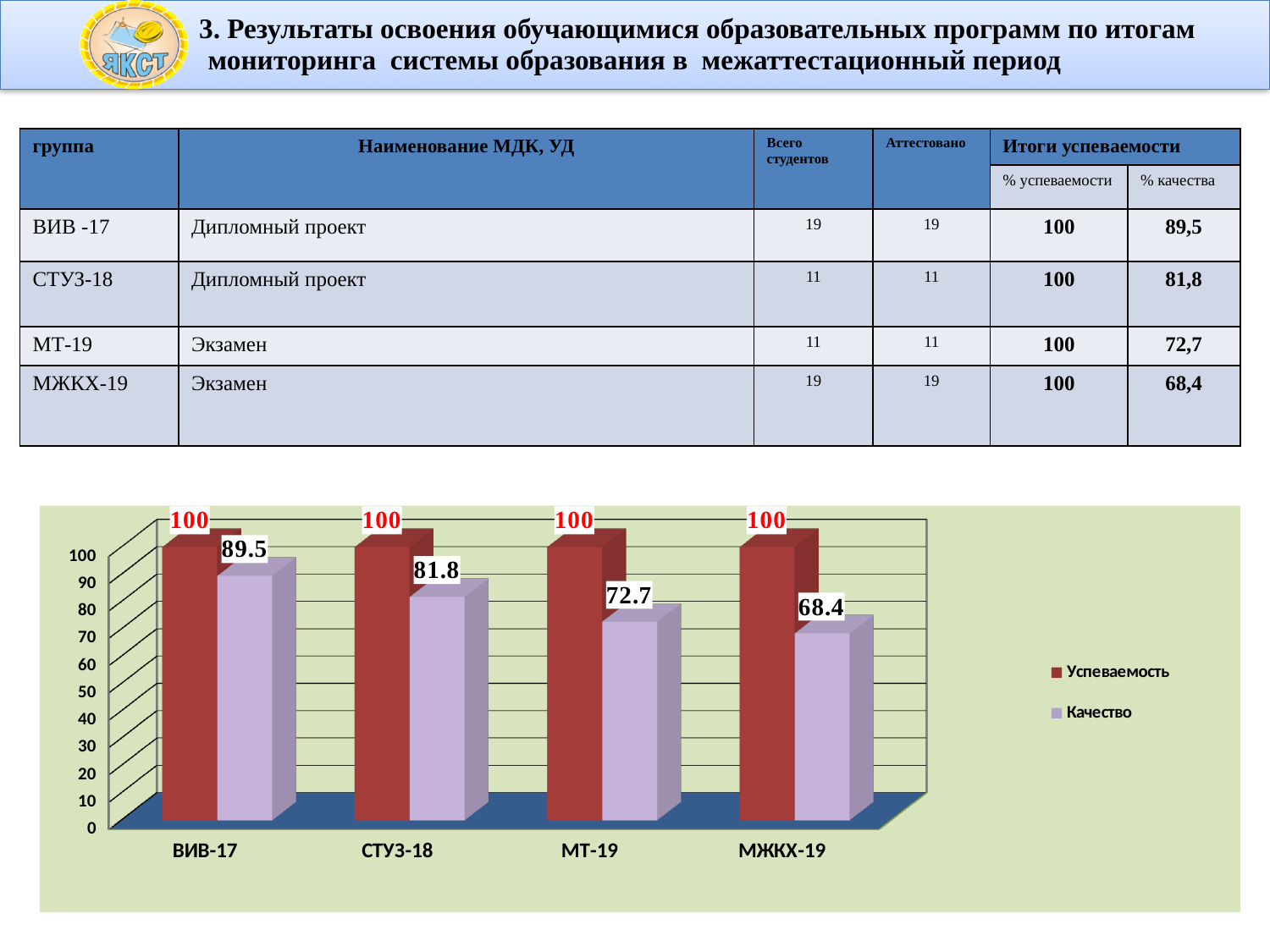
How many series does the chart legend list? 2 What is the difference between the Качество values for ВИВ-17 and МЖКХ-19? 21.1 What is the value of Качество for ВИВ-17? 89.5 Which is larger, the Качество value for СТУЗ-18 or for МТ-19? СТУЗ-18 Which group has the lowest Качество value? МЖКХ-19 How many groups are shown on the x axis of the chart? 4 What kind of chart is shown on the slide? bar chart What is the value of Качество for МЖКХ-19? 68.4 What is the value of Качество for СТУЗ-18? 81.8 Do the Качество values rise or fall from ВИВ-17 to МЖКХ-19? fall What is the value of Успеваемость for МТ-19? 100 Which group has the highest Качество value? ВИВ-17